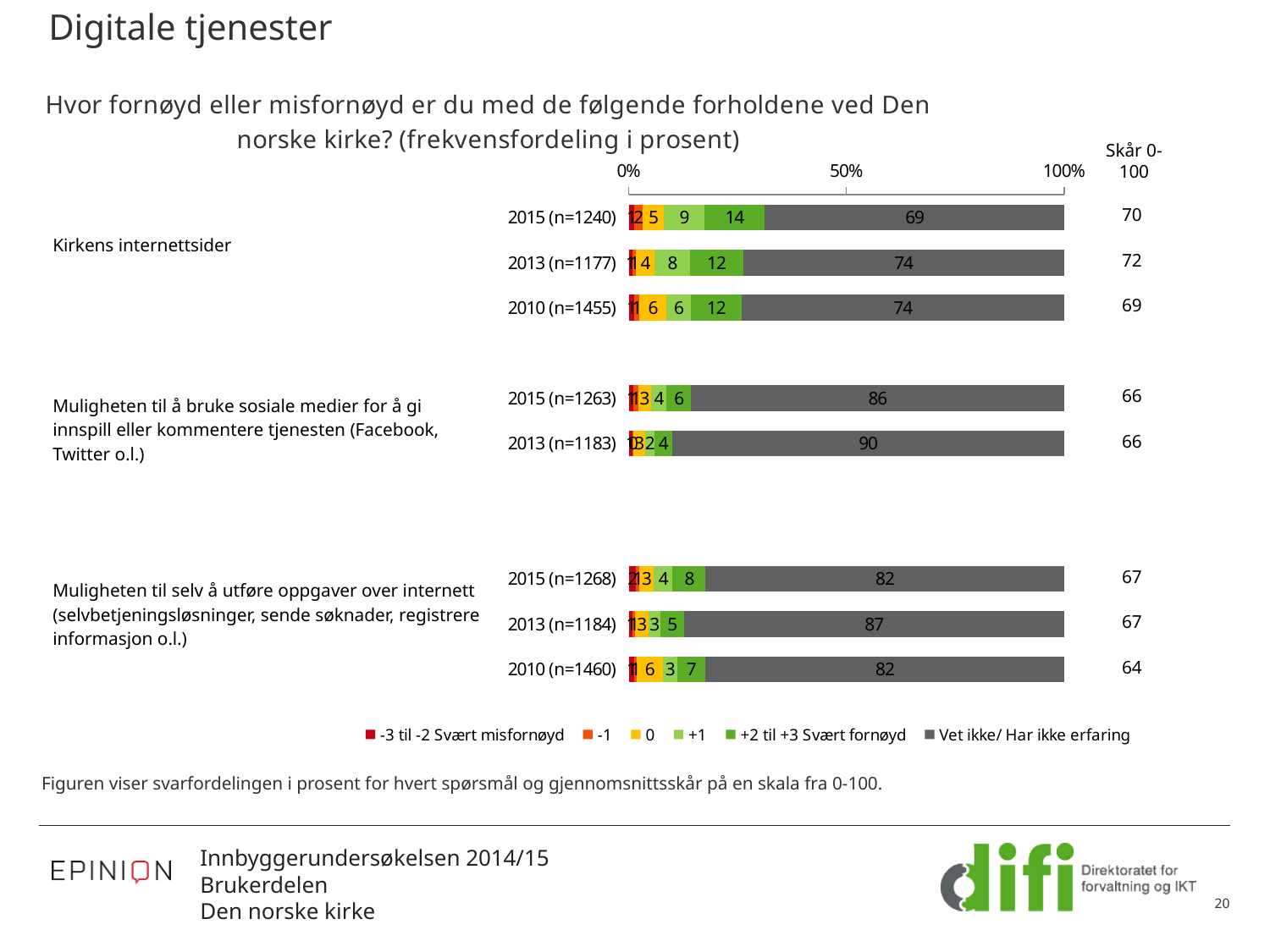
How many bars are shown in the chart? 8 Which bar has the lowest Skår 0-100 value? Muligheten til selv å utføre oppgaver over internett 2010 (n=1460) What kind of chart is shown on the slide? Stacked bar chart What is the "+2 til +3 Svært fornøyd" percentage for Kirkens internettsider in 2015 (n=1240)? 14 What is the Skår 0-100 value for Kirkens internettsider in 2013 (n=1177)? 72 What is the difference in the "Vet ikke/ Har ikke erfaring" percentage between 2013 (n=1183) and 2015 (n=1263) for Muligheten til å bruke sosiale medier? 4 What percentage of respondents answered "Vet ikke/ Har ikke erfaring" for Kirkens internettsider in 2015 (n=1240)? 69 How many series does the legend list? 6 Which is larger: the "Vet ikke/ Har ikke erfaring" share for Kirkens internettsider 2015 (n=1240) or for Muligheten til selv å utføre oppgaver over internett 2015 (n=1268)? Muligheten til selv å utføre oppgaver over internett 2015 (n=1268) Which bar has the highest Skår 0-100 value? Kirkens internettsider 2013 (n=1177) What percentage answered "Vet ikke/ Har ikke erfaring" for Muligheten til å bruke sosiale medier in 2013 (n=1183)? 90 Is the "Vet ikke/ Har ikke erfaring" share for Kirkens internettsider 2010 (n=1455) greater or less than 50%? greater